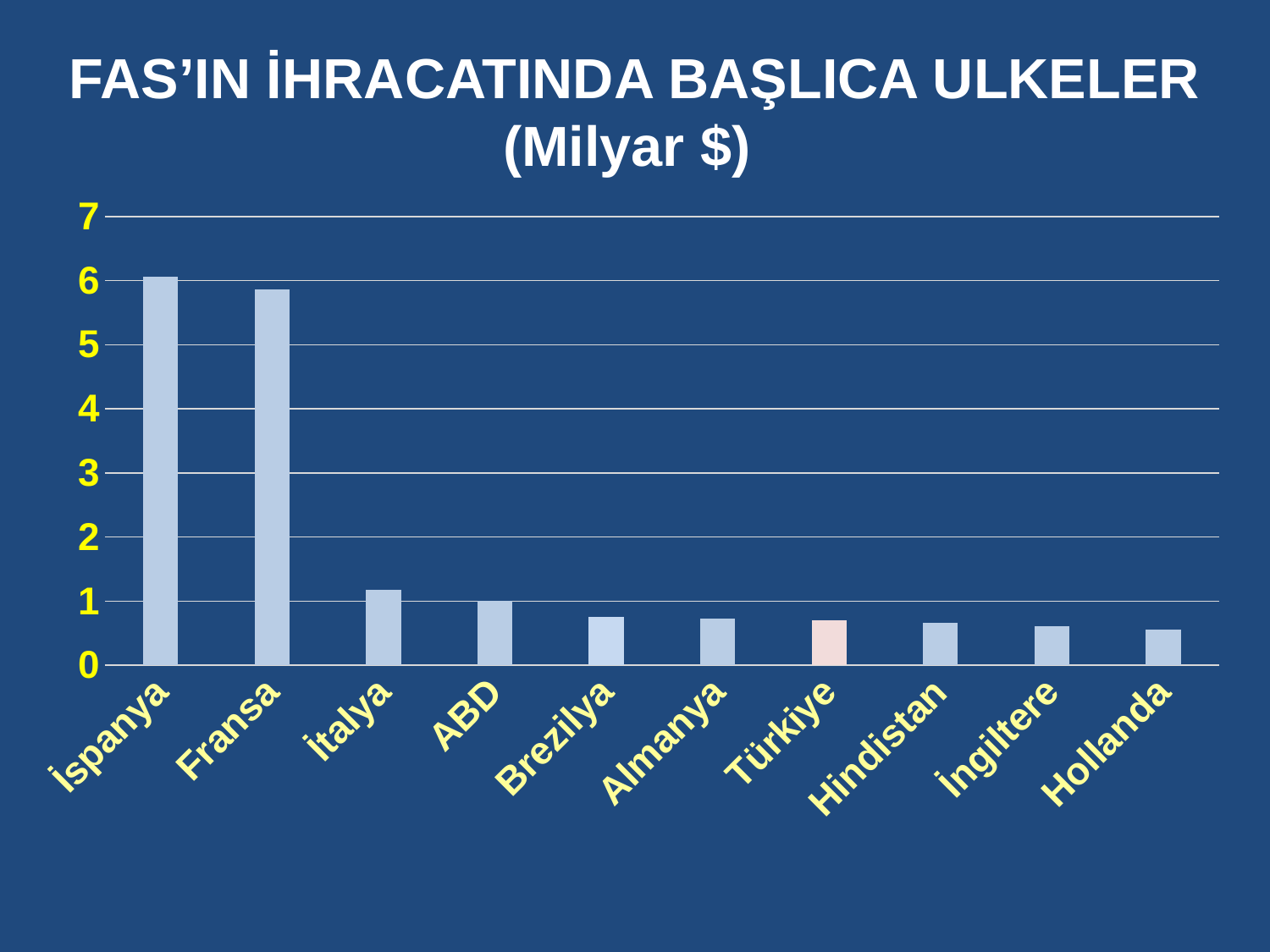
How many countries are shown on the x axis of the chart? 10 Is the value for İspanya greater or less than 5? greater What kind of chart is shown on the slide? bar chart Do the values rise or fall moving from left to right along the x axis? fall Is the value for İtalya greater or less than 1? greater Is the value for Fransa greater or less than 6? less Which has the larger value, İspanya or Fransa? İspanya Which country's bar is shown in a different colour from the others? Türkiye Which has the larger value, İtalya or ABD? İtalya Which country has the lowest value in the chart? Hollanda Which country has the highest value in the chart? İspanya